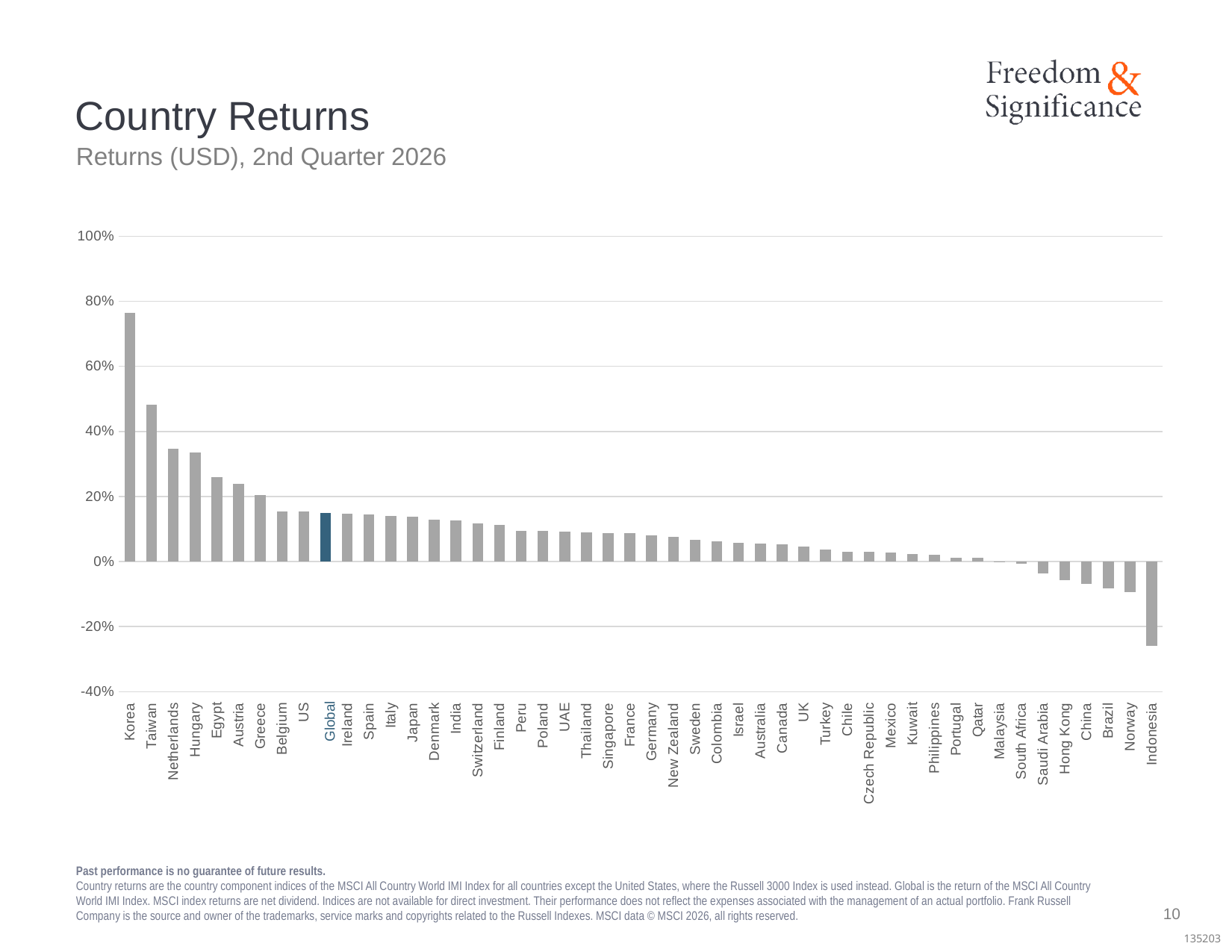
Is the value for Taiwan greater or less than 40%? greater Is the value for Global greater or less than 20%? less Which country has the lowest return in the chart? Indonesia Is the value for Indonesia greater or less than -20%? less Which has the larger return, Brazil or Hungary? Hungary Which bar is highlighted in a different colour from the others? Global Which country has the highest return in the chart? Korea Which has the larger return, Egypt or Greece? Egypt Do the values generally rise or fall moving from left to right along the x axis? fall What type of chart is shown on the slide? bar chart